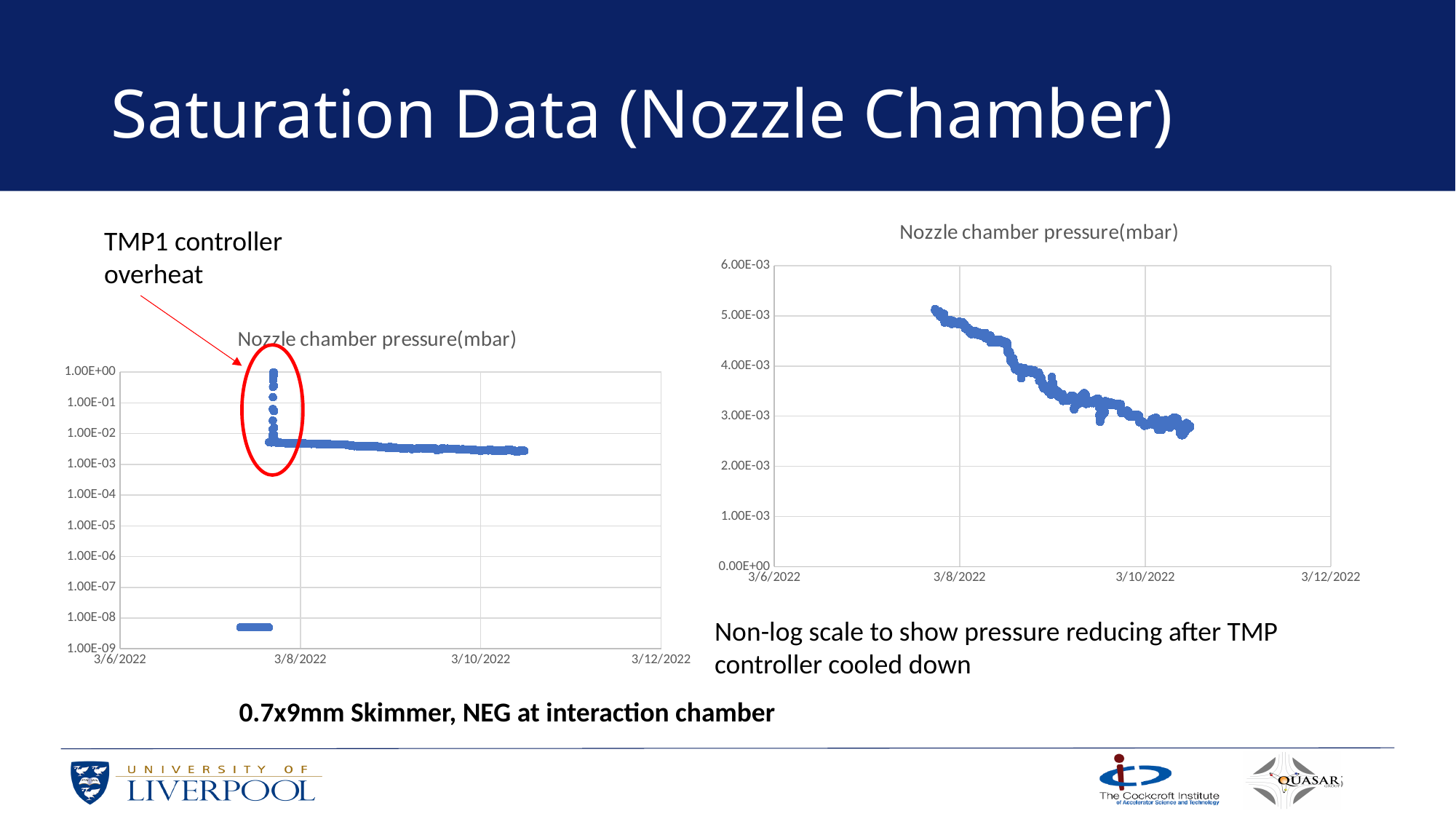
In the left-hand chart, are the pressure values after 3/10/2022 greater or less than 1.00E-03? greater In the right-hand chart, do the pressure values rise or fall from 3/8/2022 to 3/10/2022? fall What is the highest y-axis tick label on the right-hand chart? 6.00E-03 In the right-hand chart, is the pressure value at 3/8/2022 greater or less than 6.00E-03? less What is the title shown on the left-hand chart? Nozzle chamber pressure(mbar) In the left-hand chart, are the earliest data points (before 3/8/2022) greater or less than 1.00E-08? less In the right-hand chart, which date has the larger pressure value, 3/8/2022 or 3/10/2022? 3/8/2022 What kind of chart is the right-hand chart titled 'Nozzle chamber pressure(mbar)'? scatter chart